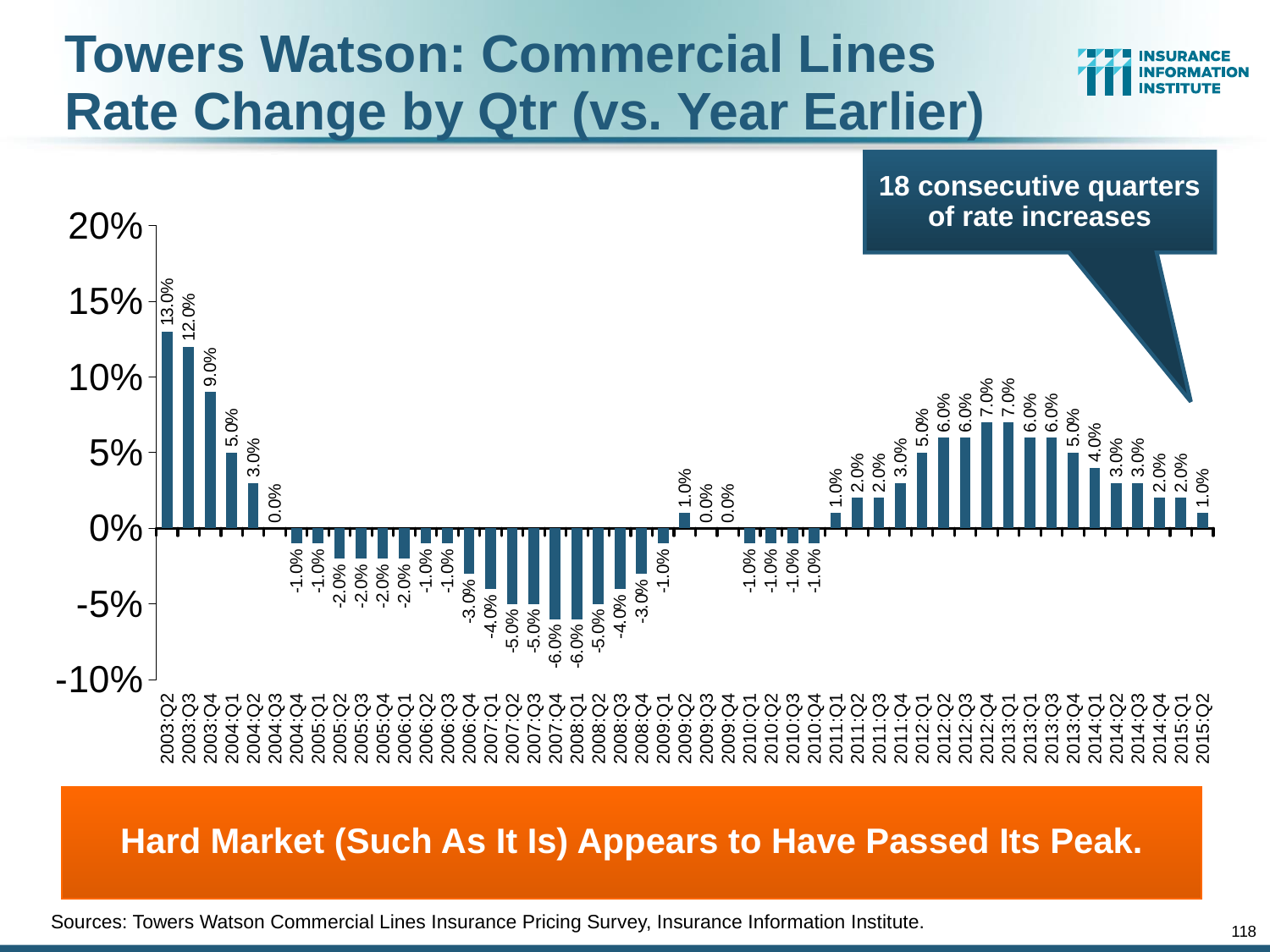
What is the rate change for 2012:Q4? 7.0% According to the callout on the chart, how many consecutive quarters of rate increases were there? 18 What kind of chart is shown on the slide? bar chart Which quarter has the highest rate change? 2003:Q2 Which is larger, the rate change for 2012:Q1 or for 2014:Q1? 2012:Q1 What is the rate change for 2003:Q2? 13.0% What is the difference between the rate change in 2003:Q2 and 2003:Q3? 1.0% How many quarters are plotted on the chart? 49 Do the rate changes rise or fall from 2013:Q1 to 2015:Q2? fall What is the rate change for 2007:Q4? -6.0% What is the rate change for 2015:Q2? 1.0% What is the lowest rate change shown on the chart? -6.0%